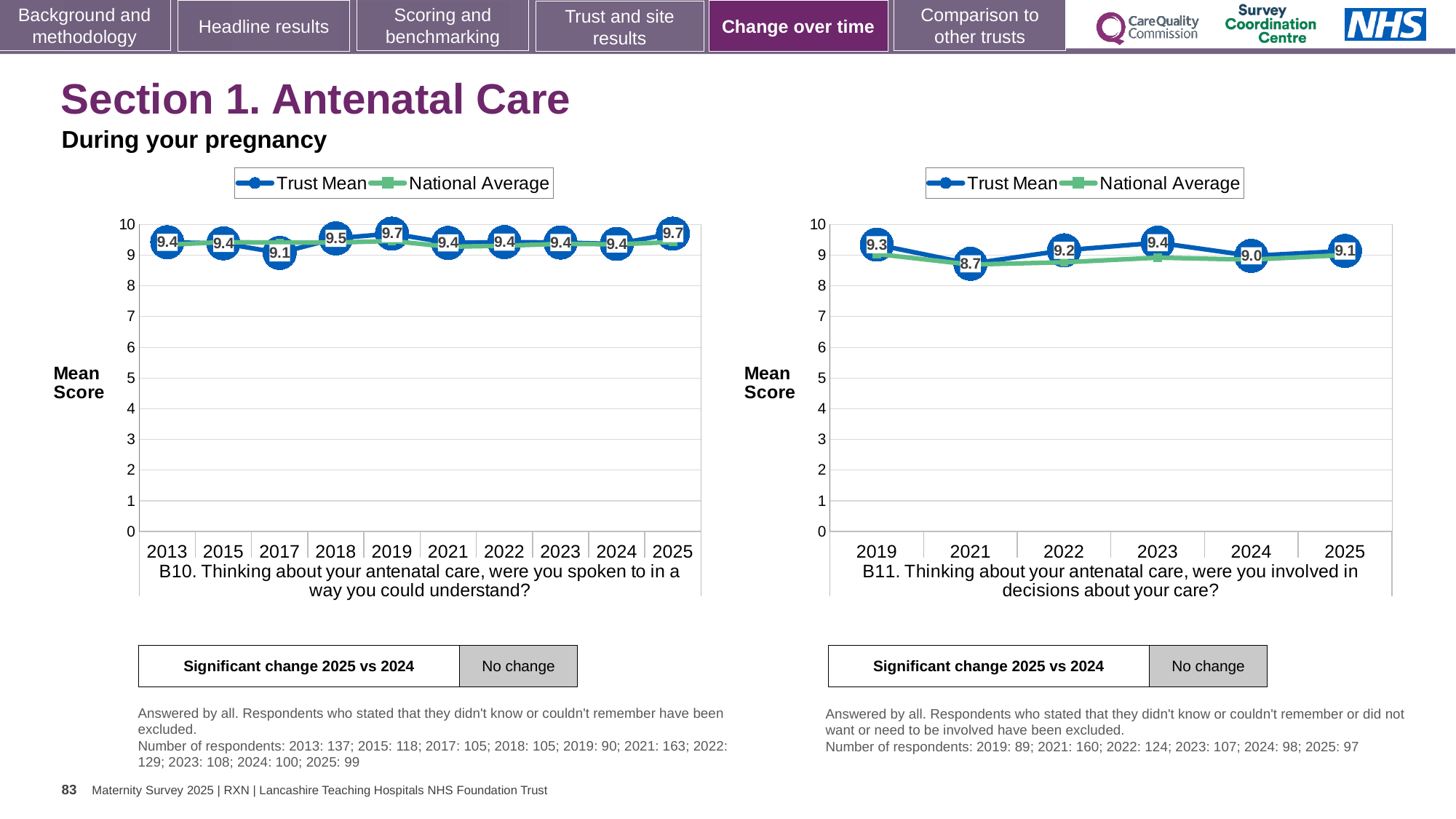
In the B11 chart on the right, is the National Average for 2021 greater or less than 8? greater In the B11 chart on the right, what is the Trust Mean for 2021? 8.7 In the B10 chart on the left, what is the Trust Mean for 2017? 9.1 In the B11 chart on the right, what is the difference between the Trust Mean for 2023 and for 2021? 0.7 What kind of chart is the B10 chart on the left? Line chart In the B11 chart on the right, which year has the highest Trust Mean? 2023 In the B10 chart on the left, which year has the lowest Trust Mean? 2017 In the B11 chart on the right, is the Trust Mean higher in 2019 or in 2024? 2019 How many years are plotted in the B10 chart on the left? 10 In the B11 chart on the right, does the Trust Mean rise or fall from 2019 to 2021? Fall In the B10 chart on the left, what is the Trust Mean for 2025? 9.7 How many series does the legend of the B11 chart on the right list? 2